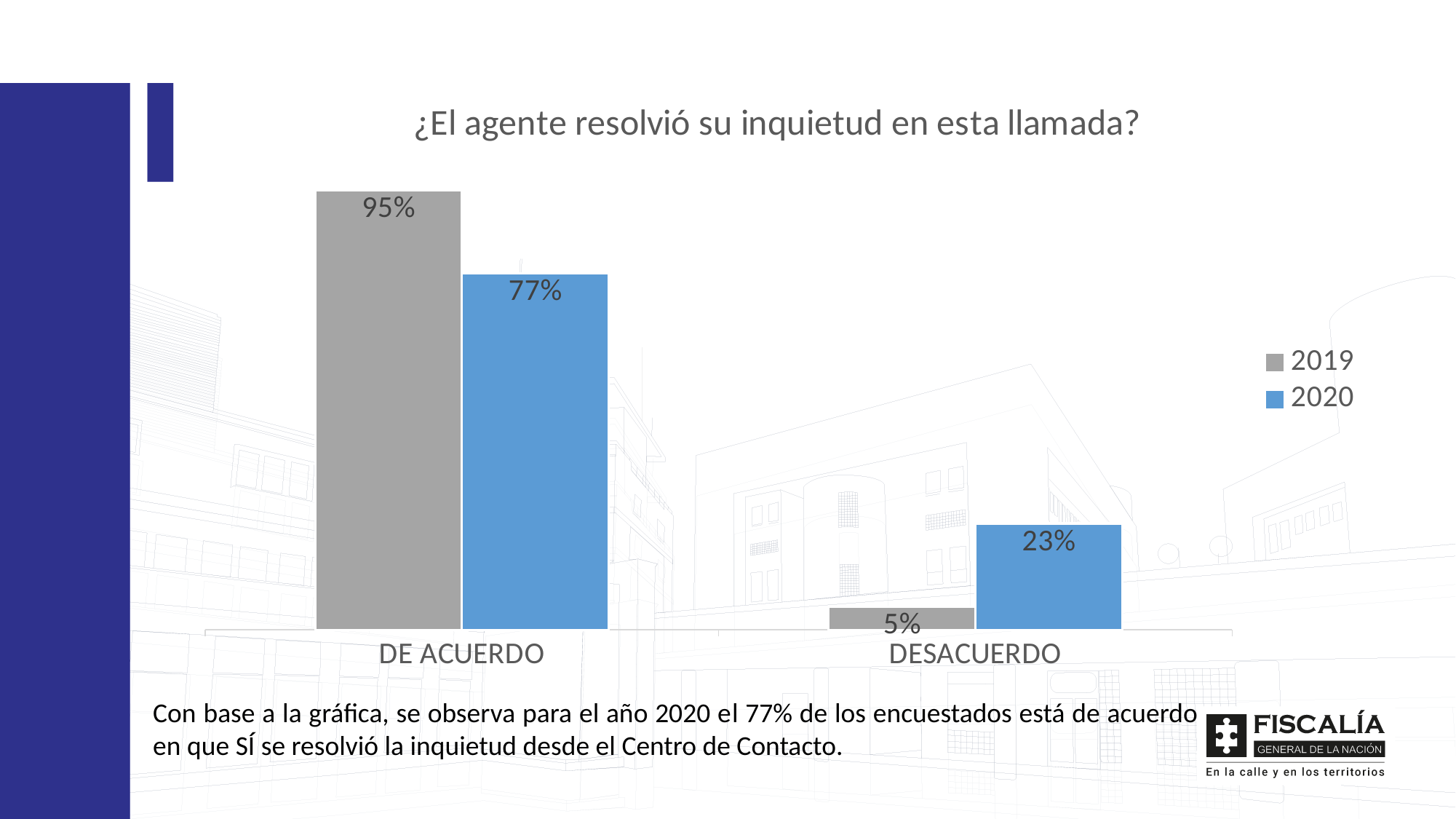
Which category has the highest value in the 2019 series? DE ACUERDO Which is larger for DESACUERDO, the 2019 value or the 2020 value? 2020 What is the value for DESACUERDO in 2019? 5% What is the difference between the 2020 and 2019 values for DESACUERDO? 18% How many series does the legend list? 2 What is the difference between the 2019 and 2020 values for DE ACUERDO? 18% Which category has the lowest value in the 2020 series? DESACUERDO What kind of chart is shown on the slide? Bar chart What is the value for DESACUERDO in 2020? 23% What is the value for DE ACUERDO in 2019? 95% How many categories are shown on the x axis? 2 What is the value for DE ACUERDO in 2020? 77%